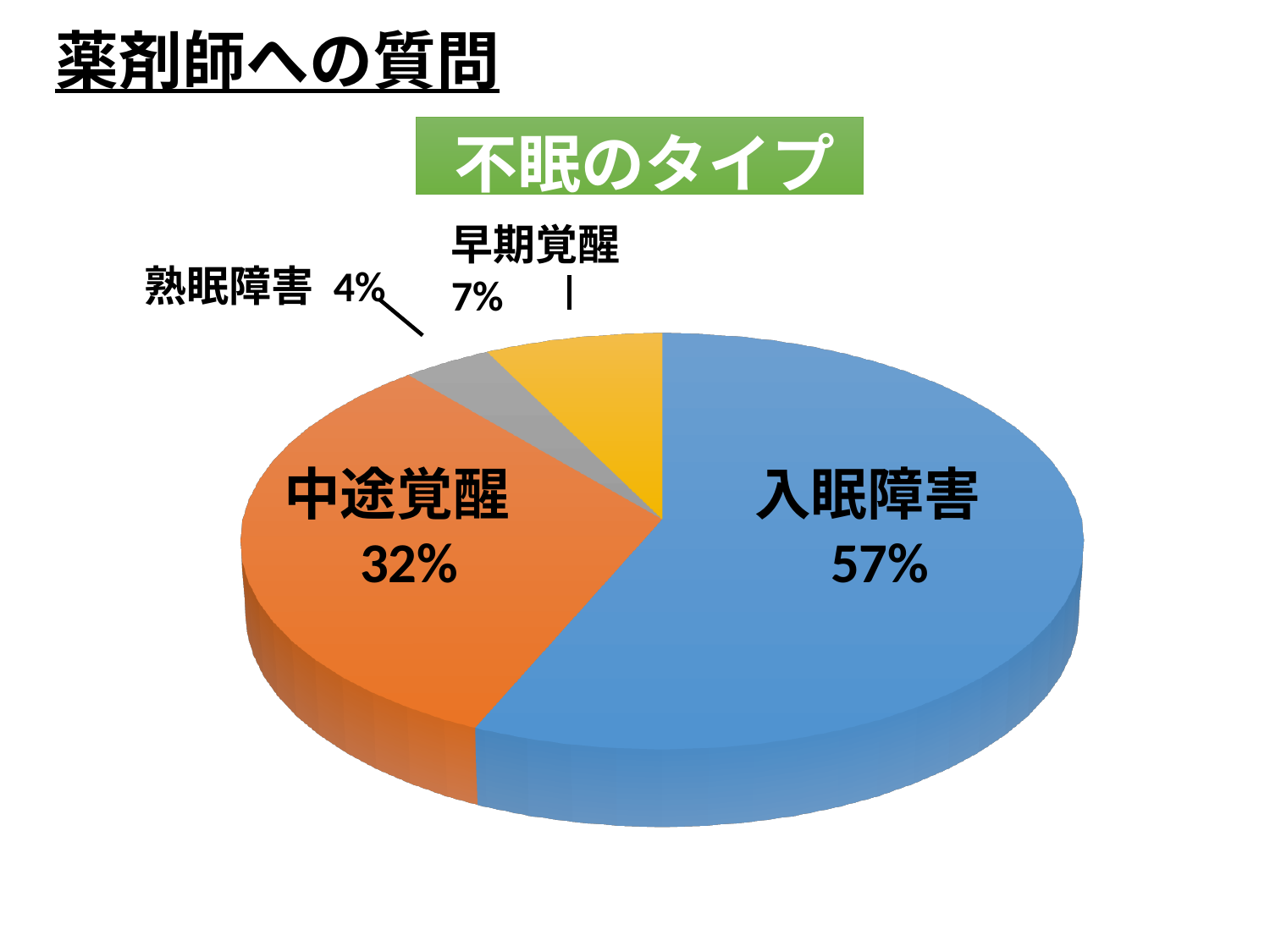
How many categories are shown in the pie chart? 4 What share of the pie does 中途覚醒 have? 32% What share of the pie does 早期覚醒 have? 7% Which category has the largest slice of the pie? 入眠障害 What share of the pie does 入眠障害 have? 57% What is the difference between the shares of 早期覚醒 and 熟眠障害? 3% What kind of chart is shown on the slide? Pie chart Which is larger, the share of 中途覚醒 or the share of 早期覚醒? 中途覚醒 What is the title of the chart? 不眠のタイプ Which category has the smallest slice of the pie? 熟眠障害 What is the difference between the shares of 入眠障害 and 中途覚醒? 25%